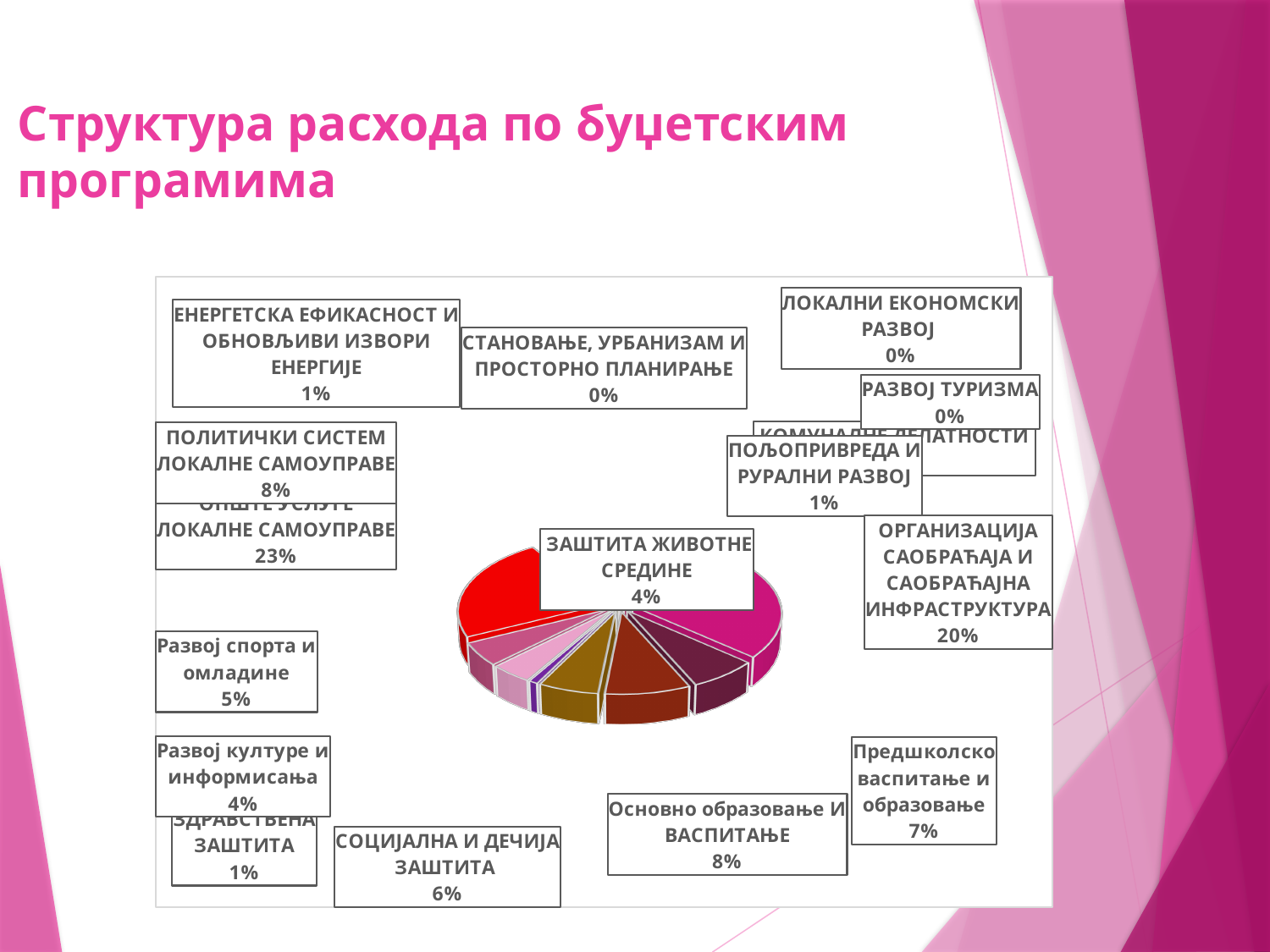
What percentage is shown for Предшколско васпитање и образовање? 7% What is the difference in percentage points between ОПШТЕ УСЛУГЕ ЛОКАЛНЕ САМОУПРАВЕ and ОРГАНИЗАЦИЈА САОБРАЋАЈА И САОБРАЋАЈНА ИНФРАСТРУКТУРА? 3 percentage points What percentage is shown for ЗАШТИТА ЖИВОТНЕ СРЕДИНЕ? 4% Which has a larger share: Основно образовање И ВАСПИТАЊЕ or Предшколско васпитање и образовање? Основно образовање И ВАСПИТАЊЕ What percentage is shown for СОЦИЈАЛНА И ДЕЧИЈА ЗАШТИТА? 6% What percentage is shown for РАЗВОЈ ТУРИЗМА? 0% What percentage is shown for Развој спорта и омладине? 5% What percentage is shown for ПОЛИТИЧКИ СИСТЕМ ЛОКАЛНЕ САМОУПРАВЕ? 8% Which budget programme has the largest share of expenditure? ОПШТЕ УСЛУГЕ ЛОКАЛНЕ САМОУПРАВЕ What share of expenditure goes to ОРГАНИЗАЦИЈА САОБРАЋАЈА И САОБРАЋАЈНА ИНФРАСТРУКТУРА? 20% What is the title of the slide containing the chart? Структура расхода по буџетским програмима What kind of chart is shown on the slide? pie chart